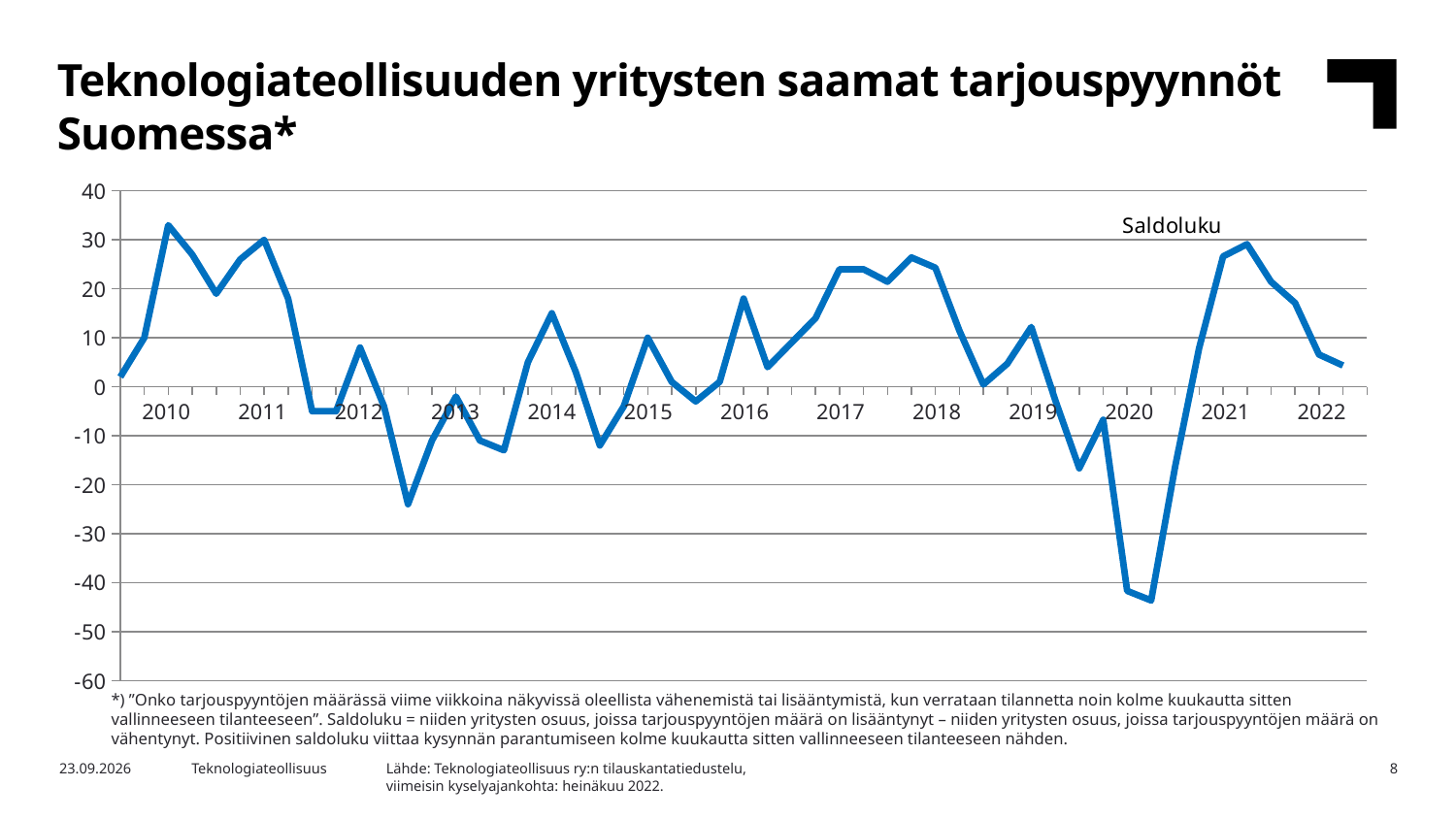
What is the name of the series plotted in the chart? Saldoluku Is the peak value in 2017 greater or less than 20? greater How many years are labelled on the x axis of the chart? 13 What is the title of the chart on the slide? Teknologiateollisuuden yritysten saamat tarjouspyynnöt Suomessa* Is the lowest value in 2020 greater or less than -40? less Is the lowest value in 2012 greater or less than -20? less In which year does the line reach its lowest point? 2020 Do the values rise or fall from the 2021 peak to the end of 2022? fall Which is larger, the lowest value in 2020 or the lowest value in 2012? the lowest value in 2012 What kind of chart is shown on the slide? line chart